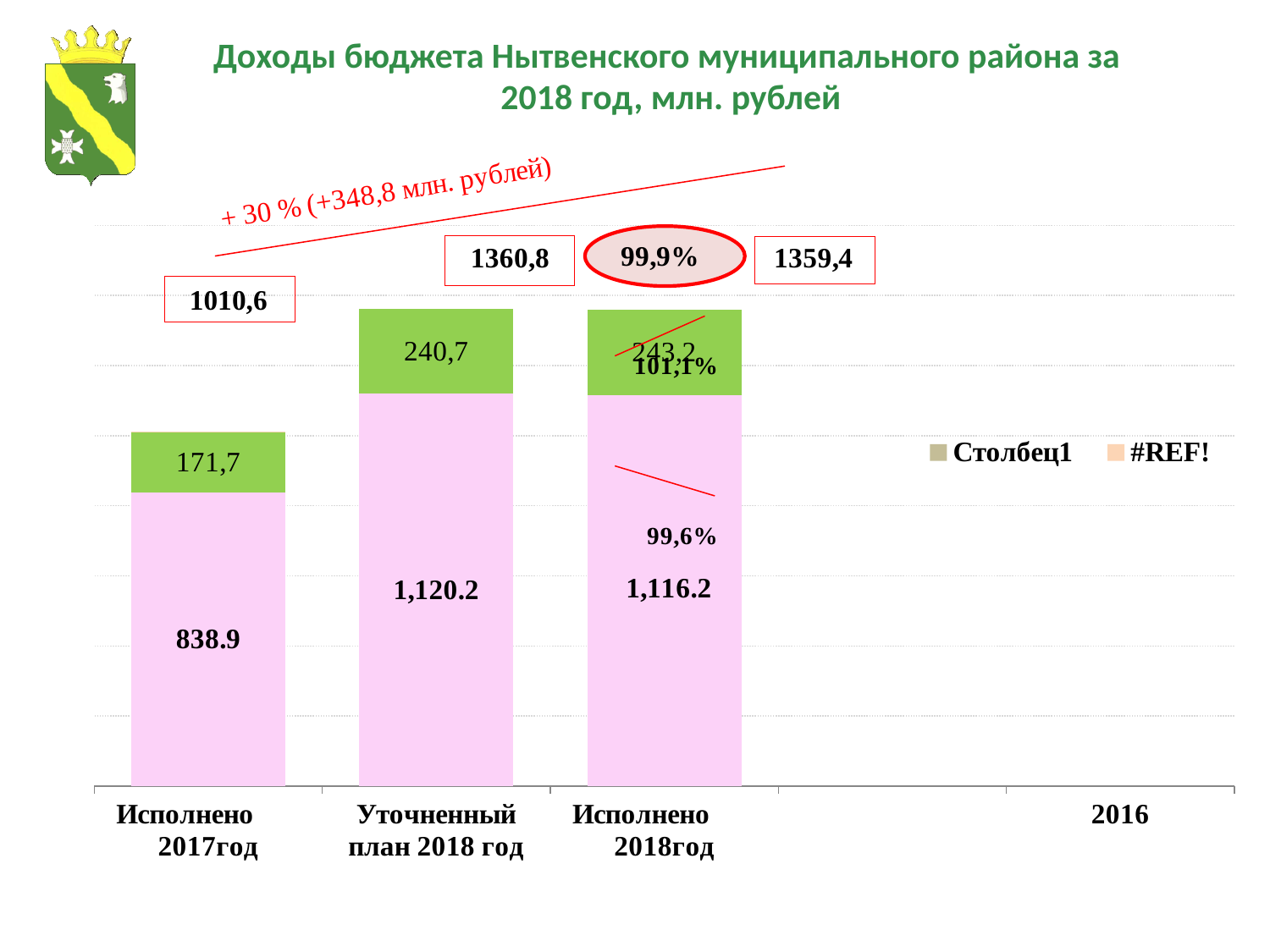
What is the difference between the pink segment of Уточненный план 2018 год (1,120.2) and the pink segment of Исполнено 2017год (838.9)? 281.3 What total is shown in the box above the Исполнено 2017год bar? 1010,6 What is the value of the pink (lower) segment for Исполнено 2017год? 838.9 What is the value of the green (upper) segment for Уточненный план 2018 год? 240,7 What total is shown in the box above the Уточненный план 2018 год bar? 1360,8 What is the value of the pink (lower) segment for Исполнено 2018год? 1,116.2 What is the value of the green (upper) segment for Исполнено 2017год? 171,7 Which category has the lowest total? Исполнено 2017год What kind of chart is shown on the slide? Stacked bar chart What percentage is shown inside the red circled oval at the top of the chart? 99,9% What total is shown in the box above the Исполнено 2018год bar? 1359,4 Which is larger, the pink segment for Исполнено 2017год or the pink segment for Уточненный план 2018 год? Уточненный план 2018 год